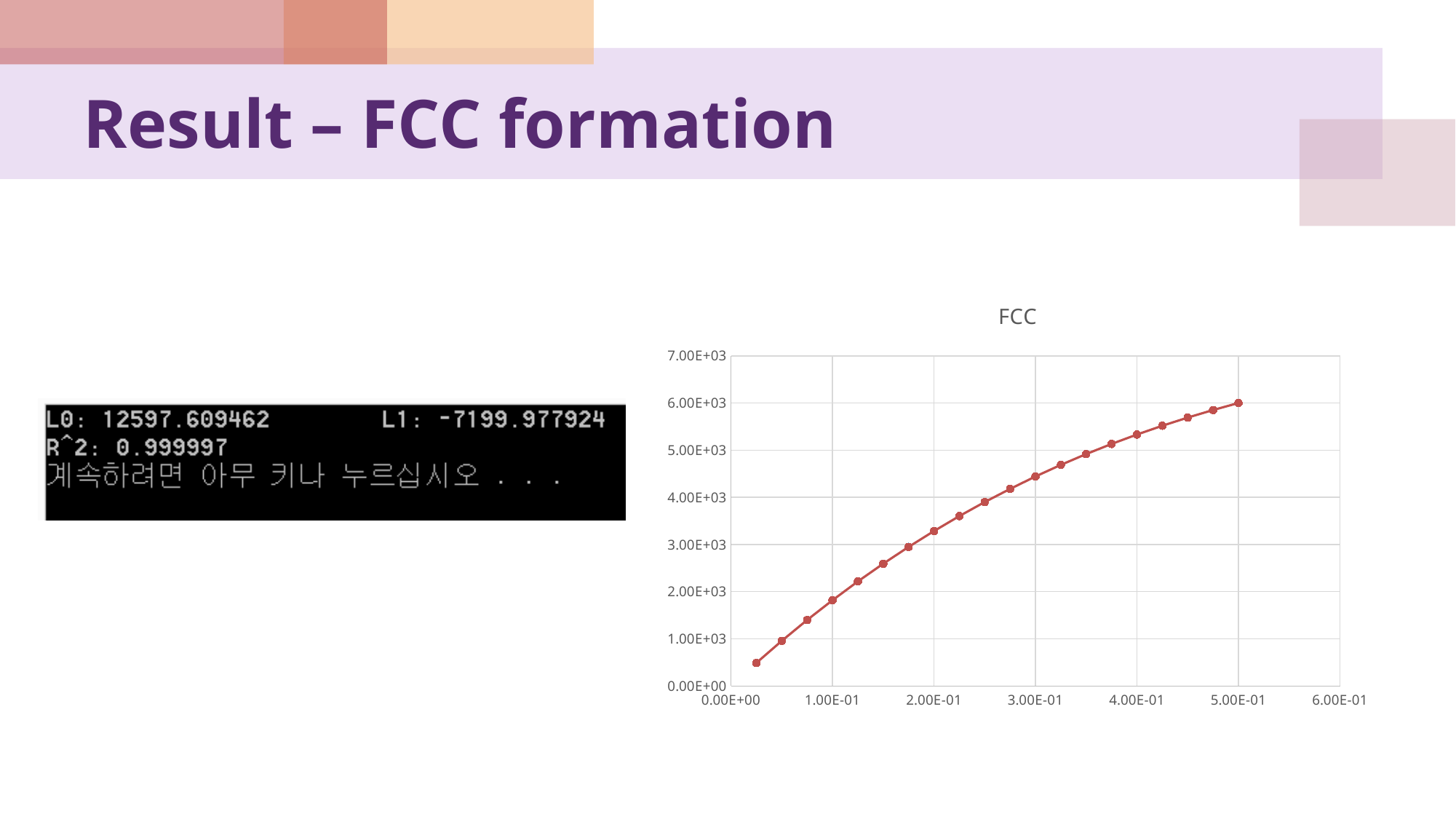
What kind of chart is shown on the slide? line chart At which x-axis position does the plotted line reach its highest value? 5.00E-01 How many data points are plotted on the line? 20 Is the value at x = 5.00E-01 greater or less than 5.00E+03? greater Is the value at x = 2.00E-01 greater or less than 4.00E+03? less What is the highest tick label shown on the y-axis? 7.00E+03 Is the value at x = 1.00E-01 greater or less than 2.00E+03? less What is the title of the chart? FCC Do the plotted values rise or fall as the x-axis value increases? rise Which has the larger value: the point at x = 2.00E-01 or the point at x = 4.00E-01? 4.00E-01